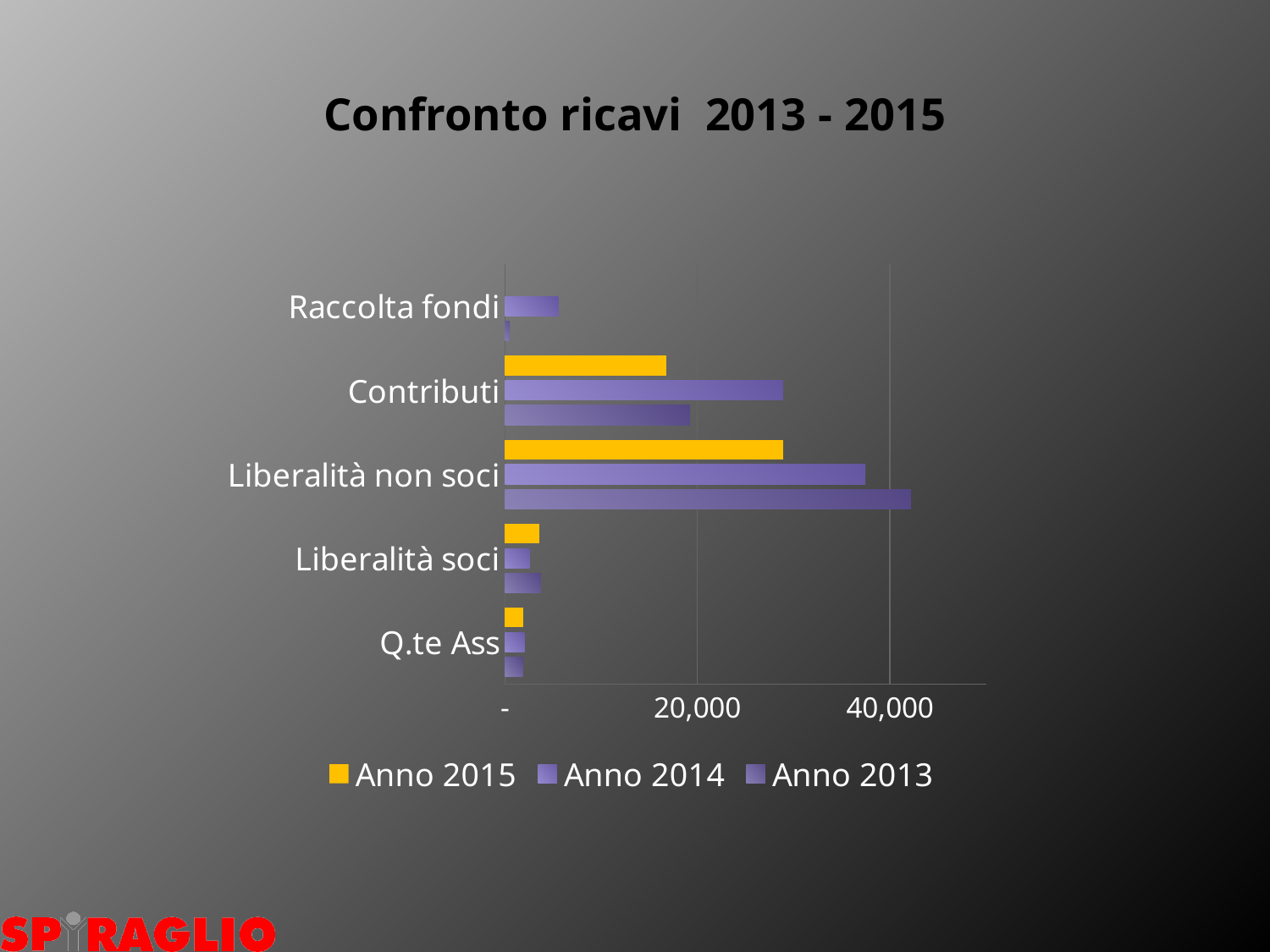
For Liberalità non soci, do the values rise or fall from Anno 2013 to Anno 2015? fall Is the Anno 2015 value for Contributi greater or less than 20,000? less Is the Anno 2014 value for Contributi greater or less than 20,000? greater How many series does the legend list? 3 Is the Anno 2013 value for Liberalità non soci greater or less than 40,000? greater What kind of chart is shown on the slide? Bar chart Which series is shown in yellow in the legend? Anno 2015 How many categories are shown on the vertical axis? 5 What is the title of the chart? Confronto ricavi 2013 - 2015 Which category has the highest value for Anno 2015? Liberalità non soci Which category has the highest value for Anno 2013? Liberalità non soci For Contributi, which is larger: the Anno 2014 value or the Anno 2015 value? Anno 2014